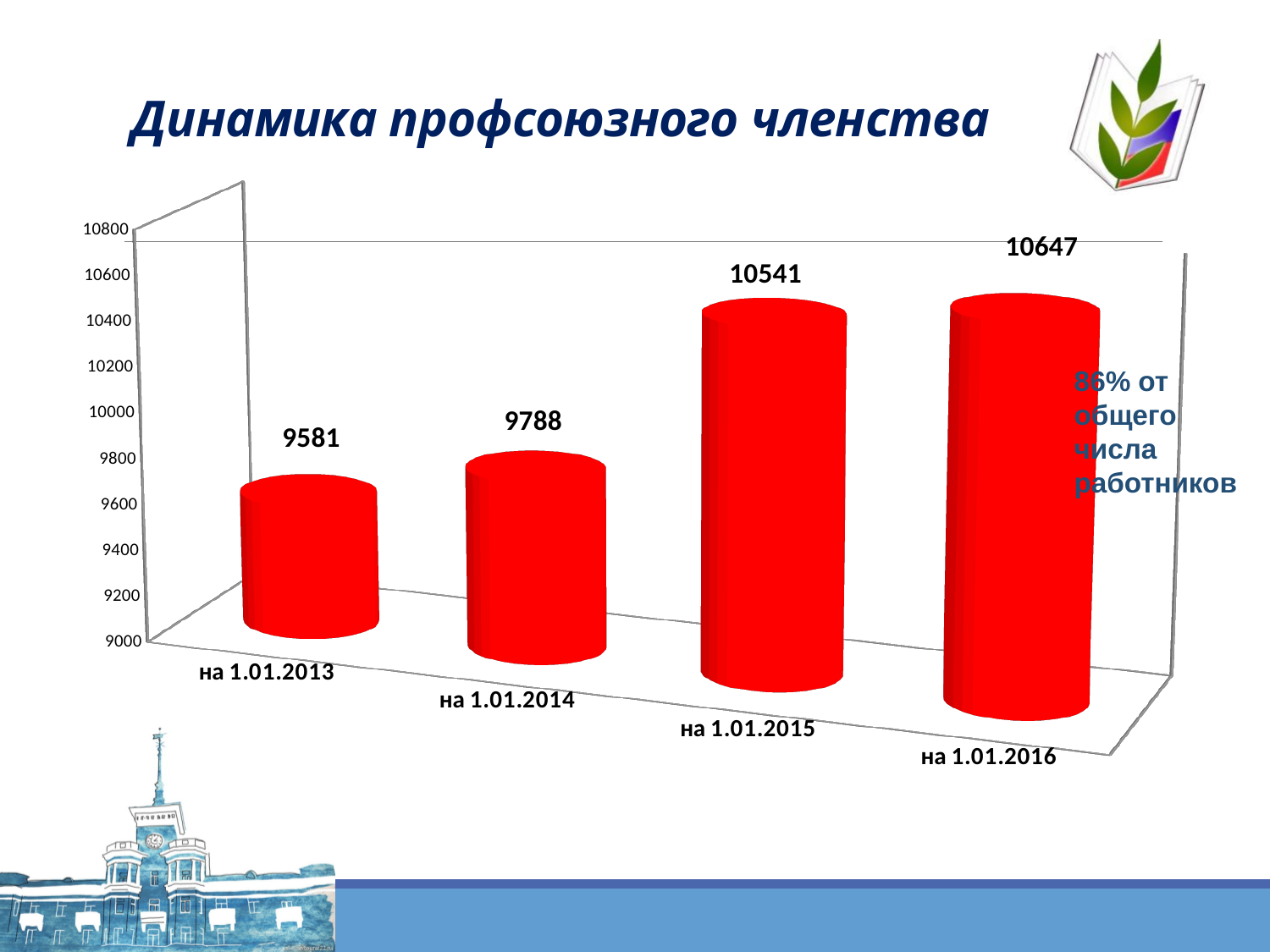
What is the value for на 1.01.2016? 10647 What is the difference between the values for на 1.01.2014 and на 1.01.2013? 207 What kind of chart is shown on the slide? bar chart Do the values rise or fall from на 1.01.2013 to на 1.01.2016? rise What is the value for на 1.01.2015? 10541 Which category has the highest value? на 1.01.2016 Which is larger, the value for на 1.01.2014 or the value for на 1.01.2015? на 1.01.2015 What is the difference between the values for на 1.01.2016 and на 1.01.2015? 106 Which category has the lowest value? на 1.01.2013 What is the title of the slide's chart? Динамика профсоюзного членства What is the value for на 1.01.2013? 9581 How many categories are shown on the x axis? 4